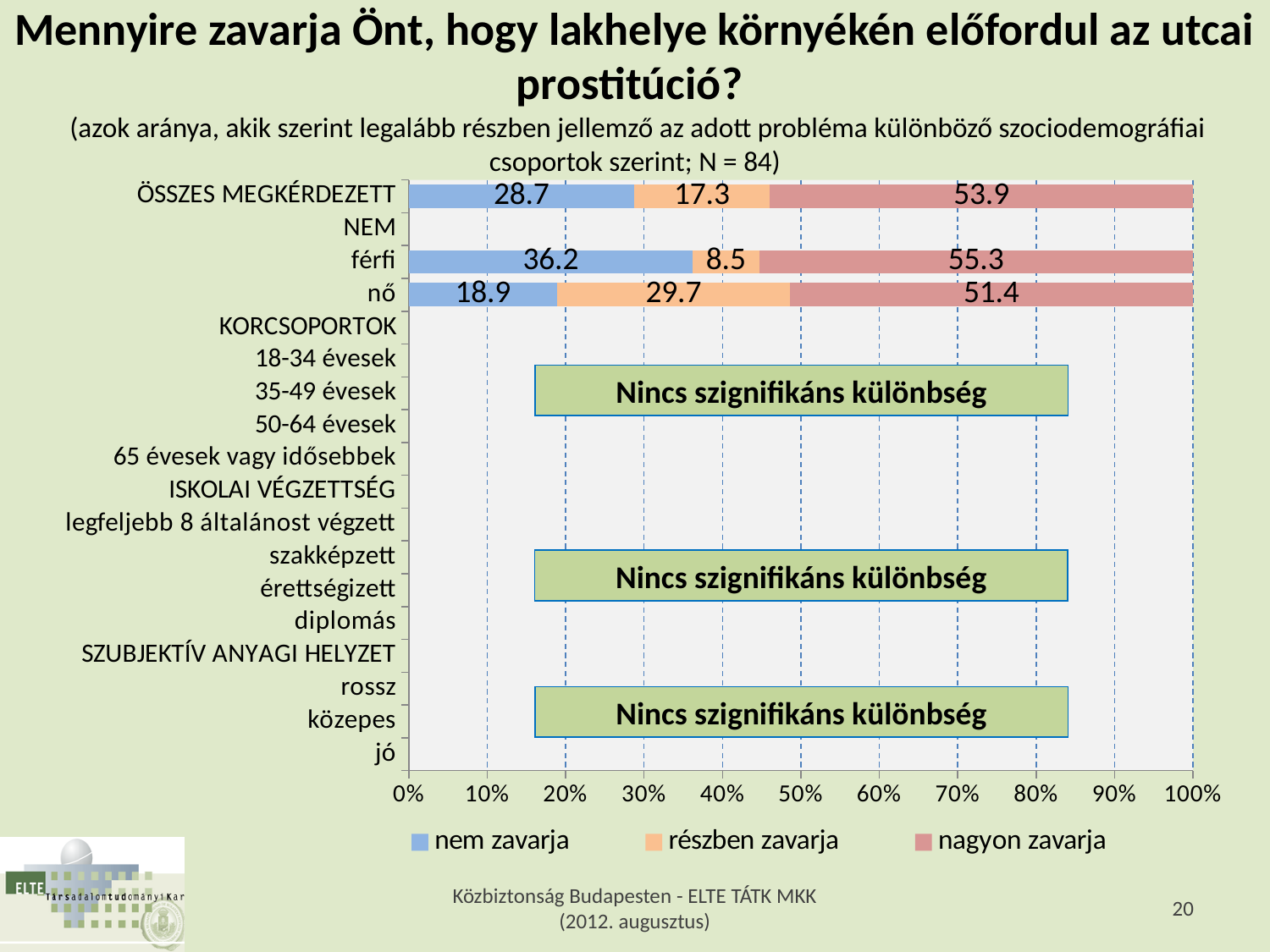
What is the value of "nagyon zavarja" for férfi? 55.3 What is the value of "részben zavarja" for nő? 29.7 What is the value of "nem zavarja" for ÖSSZES MEGKÉRDEZETT? 28.7 What kind of chart is shown on the slide? stacked bar chart Which group has the highest "nem zavarja" value: ÖSSZES MEGKÉRDEZETT, férfi or nő? férfi What is the total of the stacked bar for ÖSSZES MEGKÉRDEZETT? 99.9 Which is larger, the "részben zavarja" value for nő or for férfi? nő What is the value of "részben zavarja" for férfi? 8.5 How many series does the legend list? 3 Which group has the lowest "nagyon zavarja" value: ÖSSZES MEGKÉRDEZETT, férfi or nő? nő What text appears in the green boxes covering the age, education and financial-situation groups? Nincs szignifikáns különbség What is the difference between the "nem zavarja" values for férfi and nő? 17.3